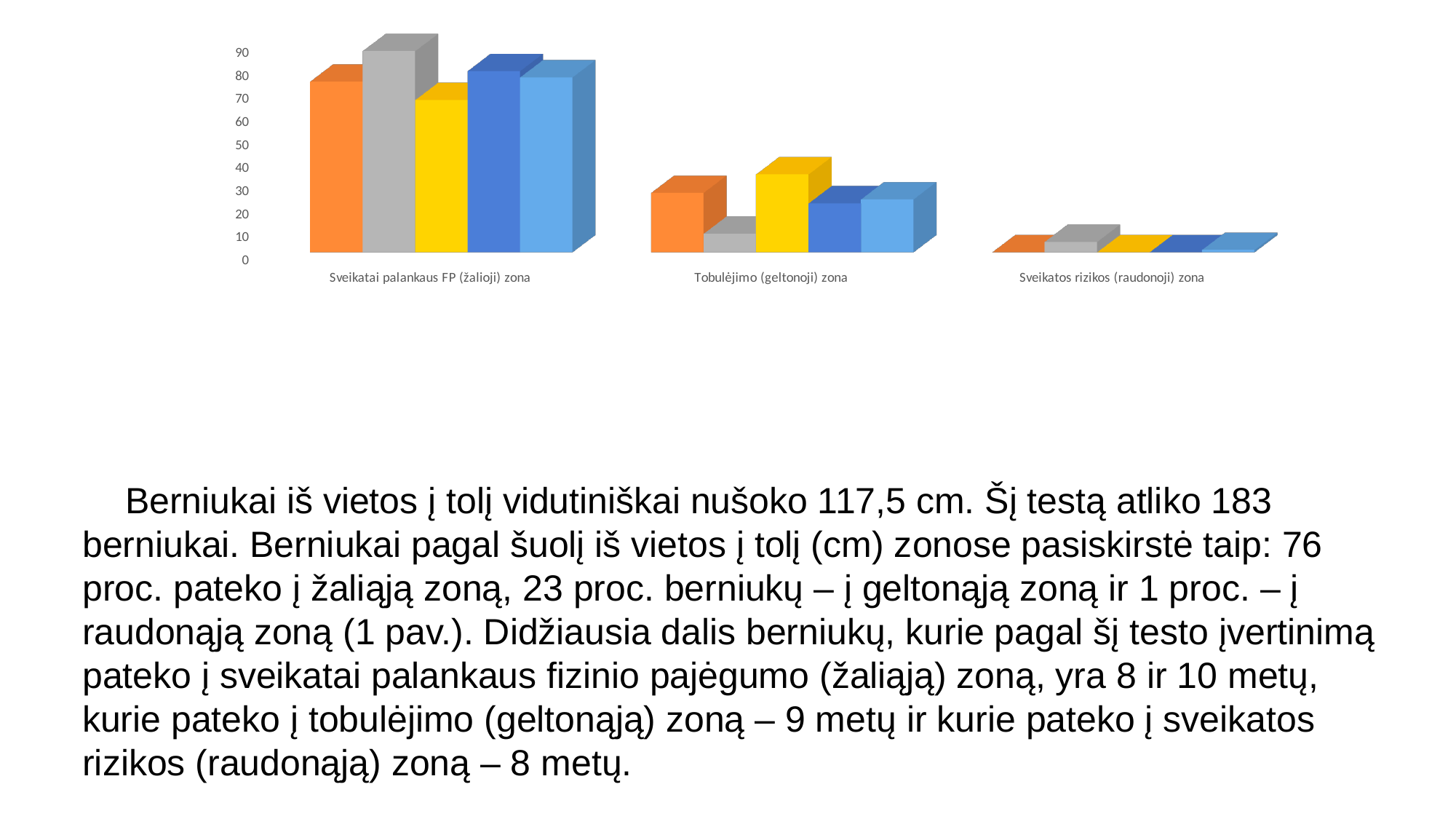
In the 'Sveikatai palankaus FP (žalioji) zona' category, which coloured bar is the tallest? gray Do the bar values rise or fall moving from left to right across the categories? fall What kind of chart is shown on the slide? bar chart Which category has the shortest bars in the chart? Sveikatos rizikos (raudonoji) zona In the 'Tobulėjimo (geltonoji) zona' category, which coloured bar is the shortest? gray How many categories are shown on the x axis of the chart? 3 In the 'Tobulėjimo (geltonoji) zona' category, which coloured bar is the tallest? yellow Which category has the tallest bars in the chart? Sveikatai palankaus FP (žalioji) zona Is the gray bar for 'Sveikatai palankaus FP (žalioji) zona' greater or less than 80? greater How many bars are plotted for each category in the chart? 5 Is the gray bar for 'Tobulėjimo (geltonoji) zona' greater or less than 20? less Is the orange bar for 'Sveikatos rizikos (raudonoji) zona' greater or less than 10? less